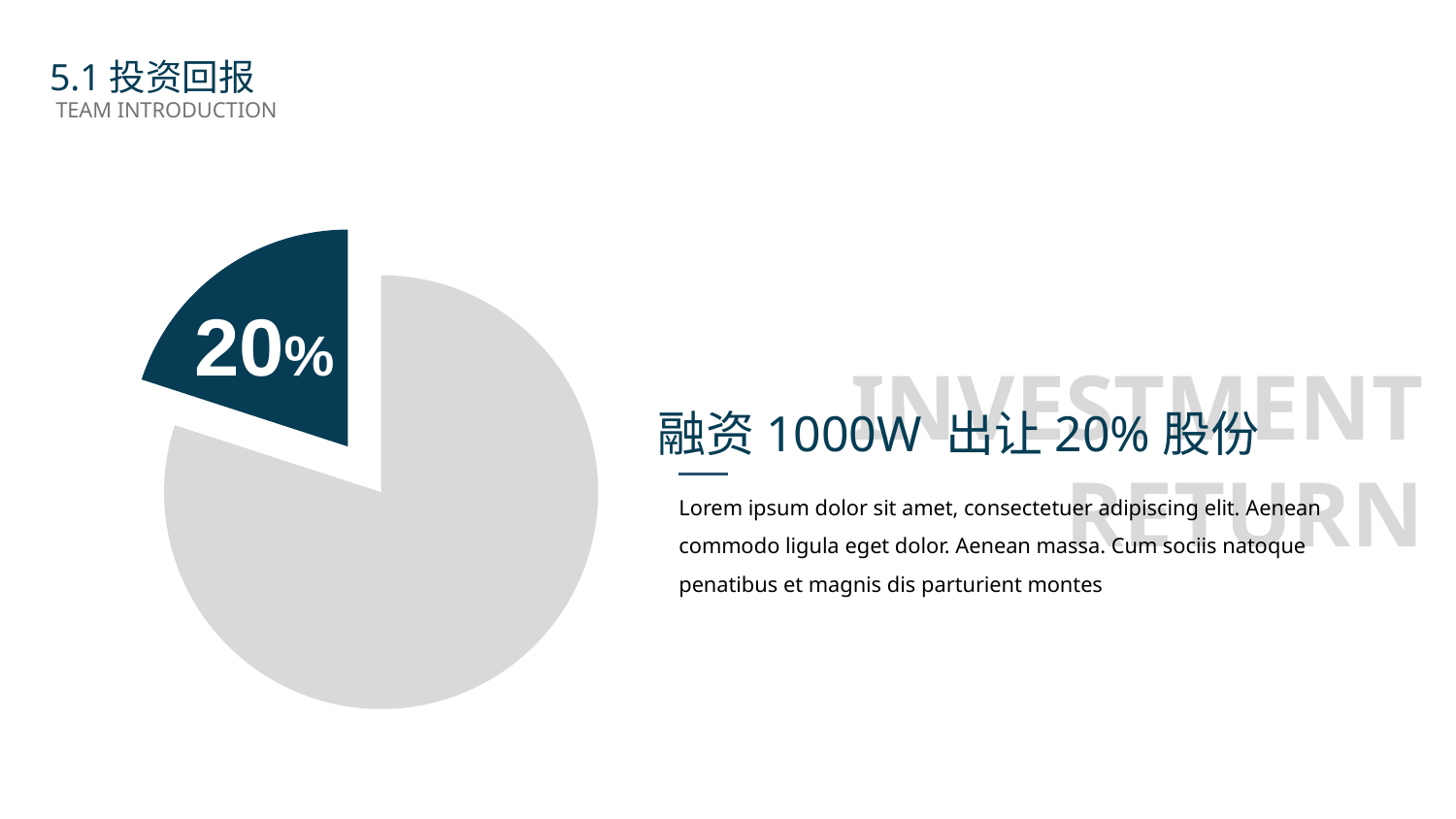
What share of the pie does the gray slice represent? 80% What kind of chart is shown on the slide? pie chart How many slices does the pie chart have? 2 Does the pie chart have a legend? No Which slice of the pie chart is larger, the dark blue one or the gray one? the gray one What share of the pie does the dark blue slice represent? 20% What percentage is printed on the highlighted slice of the pie chart? 20% What colour is the exploded slice of the pie chart? dark blue Which slice of the pie chart is the smallest? the dark blue slice labeled 20%